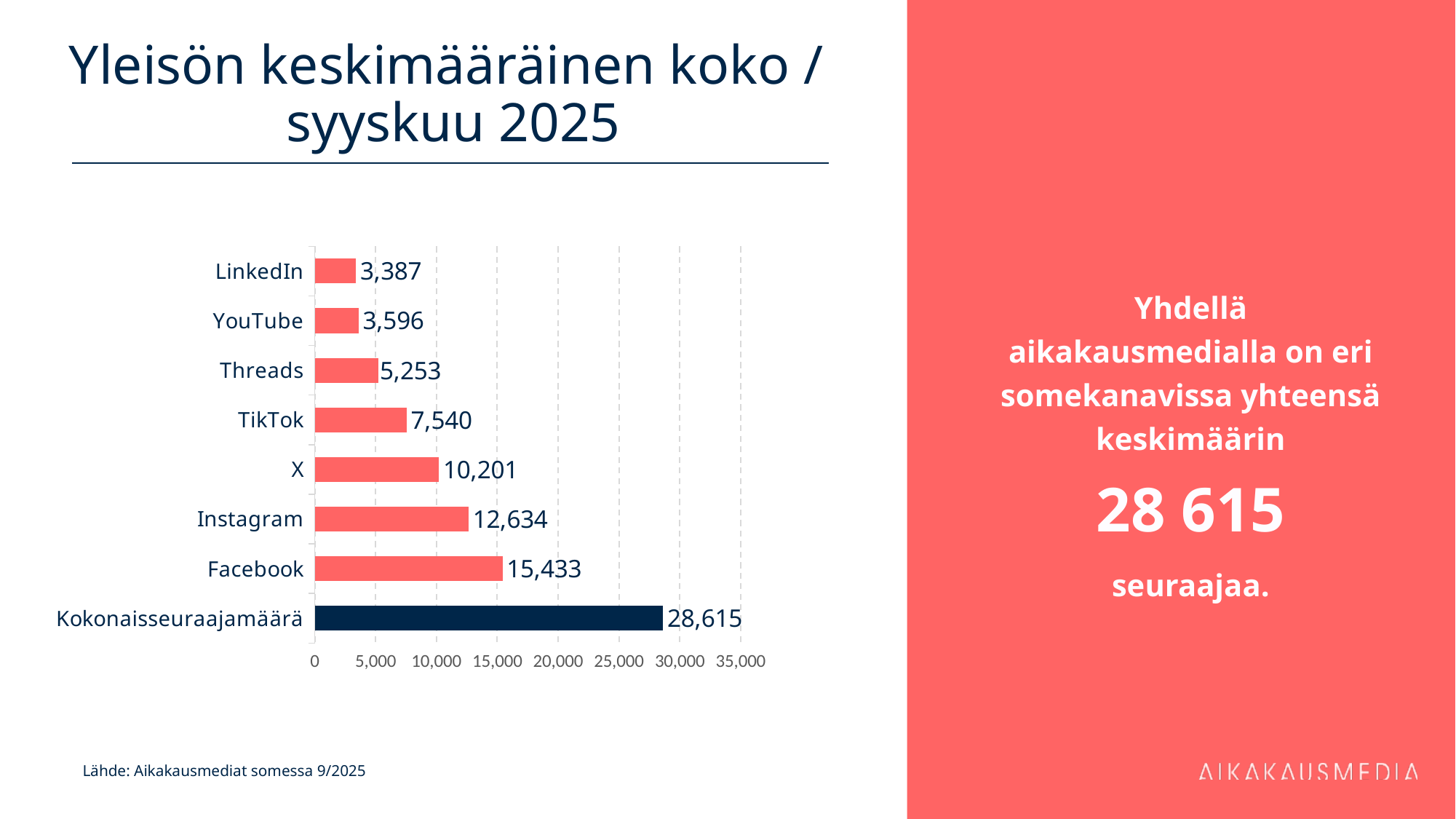
What is the value for Kokonaisseuraajamäärä? 28,615 Is the value for Instagram greater or less than 10,000? greater How many categories are shown in the chart? 8 Which category has the lowest value? LinkedIn What kind of chart is shown on the slide? bar chart What is the value for TikTok? 7,540 Which category has the highest value? Kokonaisseuraajamäärä What is the value for Facebook? 15,433 What is the difference between the values for Facebook and Instagram? 2,799 What is the difference between the values for YouTube and LinkedIn? 209 Which is larger, the value for X or the value for Threads? X What is the title of the chart on the slide? Yleisön keskimääräinen koko / syyskuu 2025